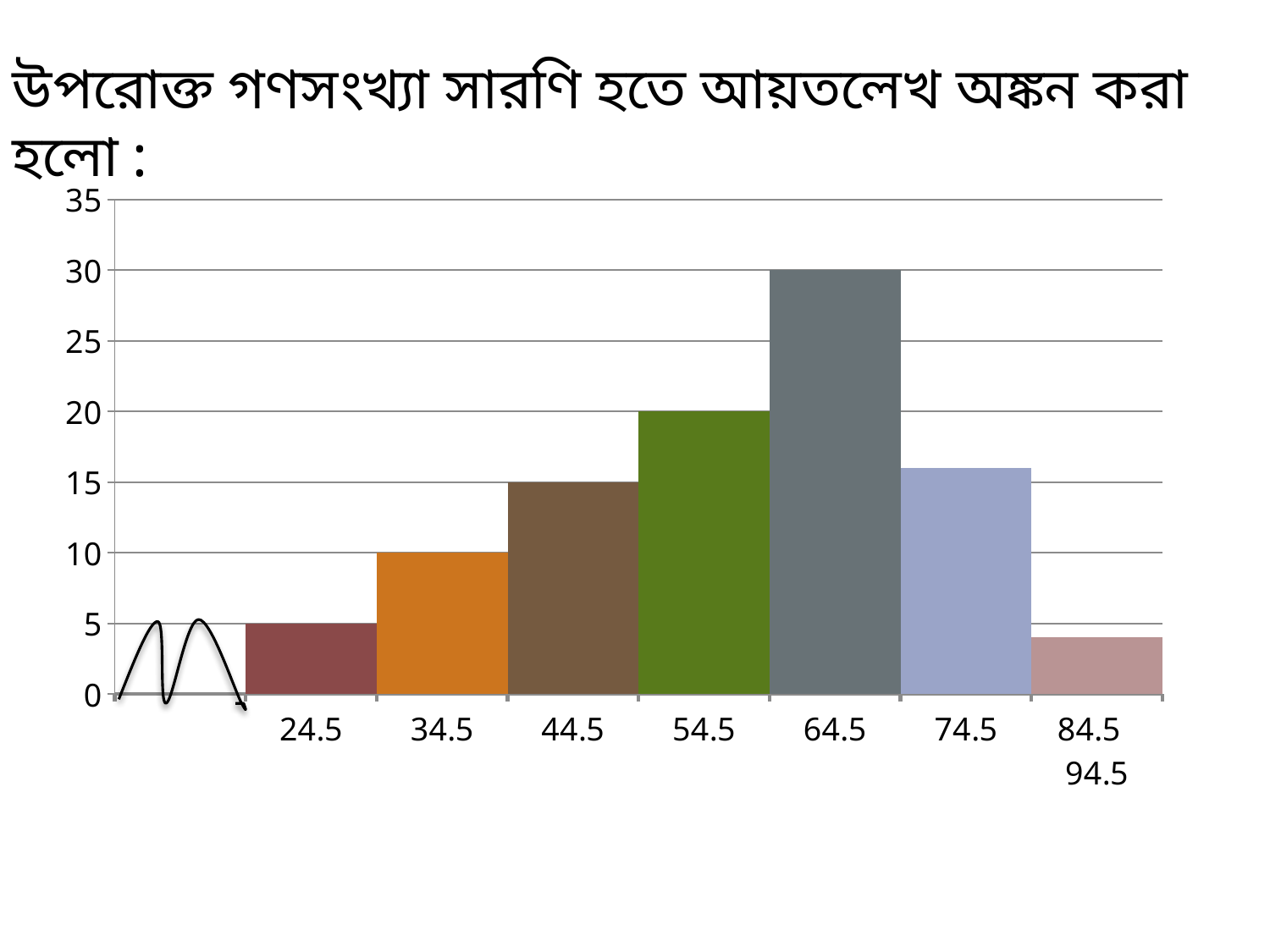
Is the value for 84.5 greater or less than 5? less What is the value of the bar at 24.5? 5 What is the difference between the values at 64.5 and 54.5? 10 What is the value of the bar at 54.5? 20 How many bars are plotted in the chart? 7 What is the value of the bar at 64.5? 30 Which category has the shortest bar? 84.5 Which has the larger value, 74.5 or 54.5? 54.5 Is the value for 74.5 greater or less than 15? greater What kind of chart is shown on the slide? bar chart What is the value of the bar at 44.5? 15 Which category has the tallest bar? 64.5